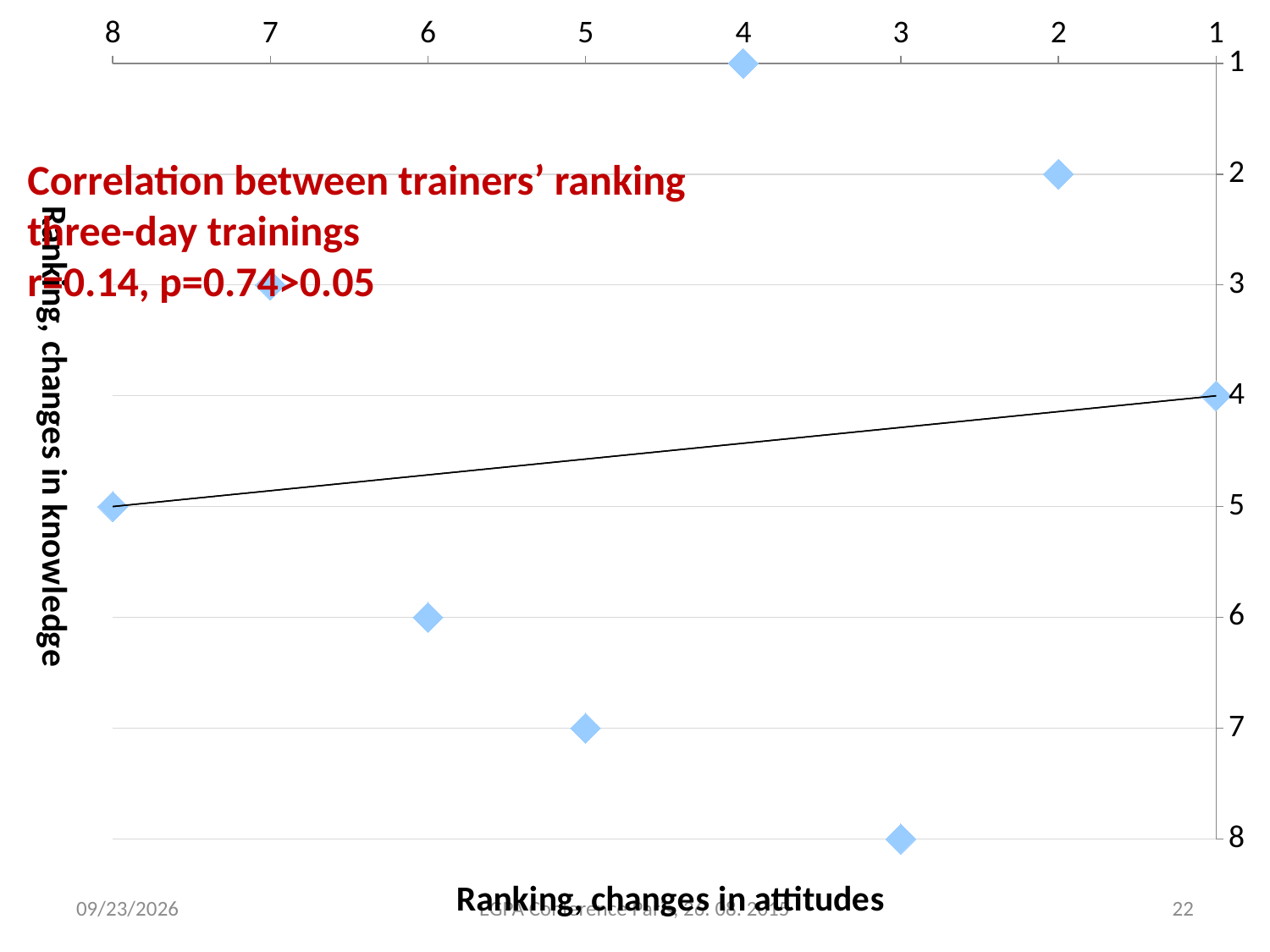
What is the ranking for changes in knowledge for the point with attitudes ranking 1? 4 What is the ranking for changes in attitudes for the point with knowledge ranking 6? 6 What is the ranking for changes in knowledge for the point with attitudes ranking 4? 1 What correlation coefficient r is stated on the slide? r=0.14 What is the ranking for changes in knowledge for the point with attitudes ranking 8? 5 How many data points are plotted on the chart? 8 What is the difference in knowledge ranking between the point with attitudes ranking 3 and the point with attitudes ranking 4? 7 What is the label of the horizontal axis? Ranking, changes in attitudes What is the ranking for changes in knowledge for the point with attitudes ranking 3? 8 What is the ranking for changes in attitudes for the point with knowledge ranking 2? 2 What is the label of the vertical axis? Ranking, changes in knowledge What kind of chart is shown on the slide? scatter chart